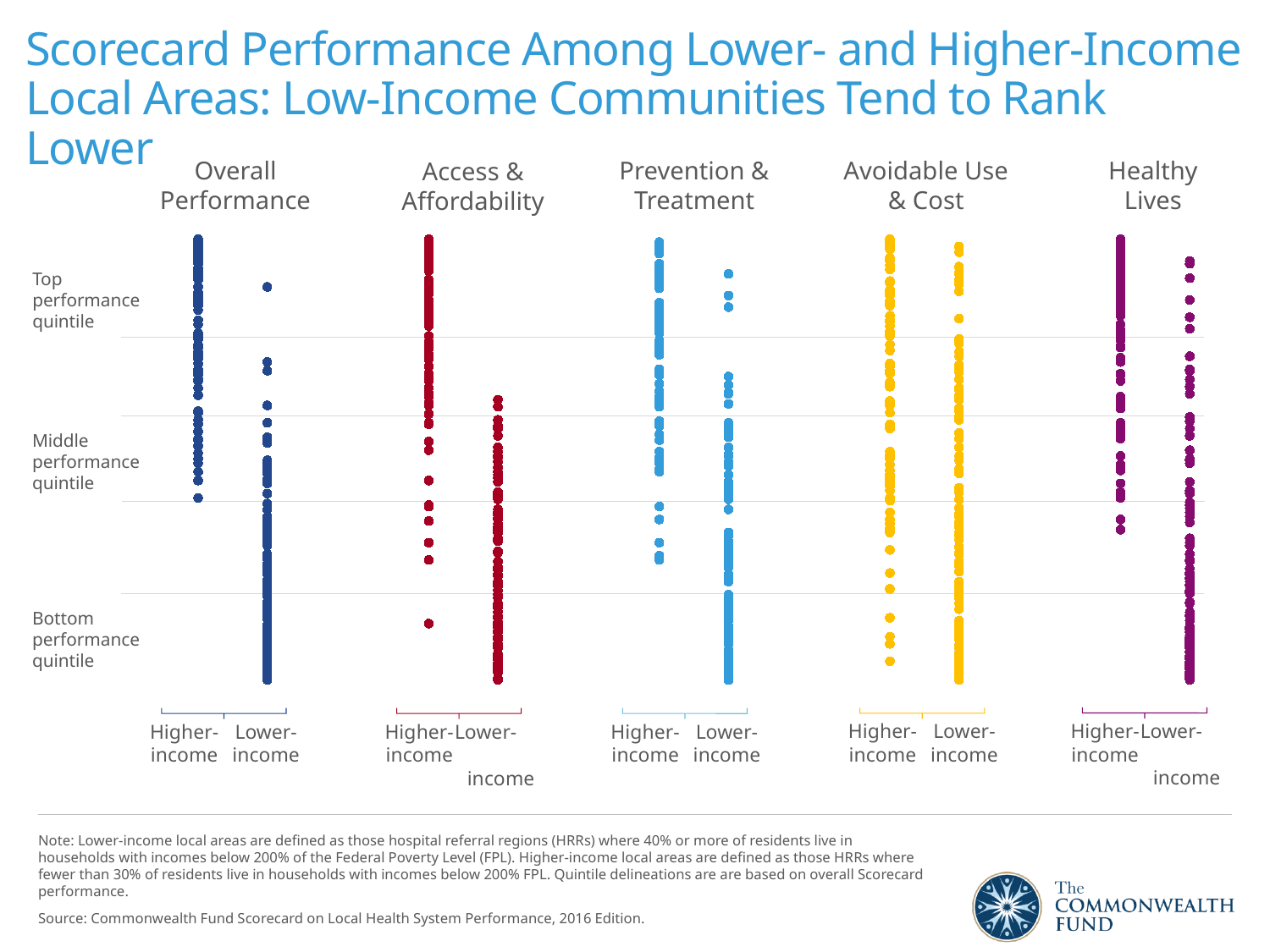
In the Prevention & Treatment panel, which income group has local areas in the bottom performance quintile? Lower-income What kind of chart is shown on the slide? Dot plot (strip chart) What colour are the dots in the Avoidable Use & Cost panel? Yellow In the Healthy Lives panel, which income group has local areas in the bottom performance quintile? Lower-income In the Overall Performance panel, which income group has more local areas in the top performance quintile? Higher-income Which panel of the chart is drawn in purple? Healthy Lives How many income groups are compared within each panel of the chart? 2 How many performance dimensions (panels) are shown across the top of the chart? 5 According to the slide title, which type of community tends to rank lower on the Scorecard? Low-income communities